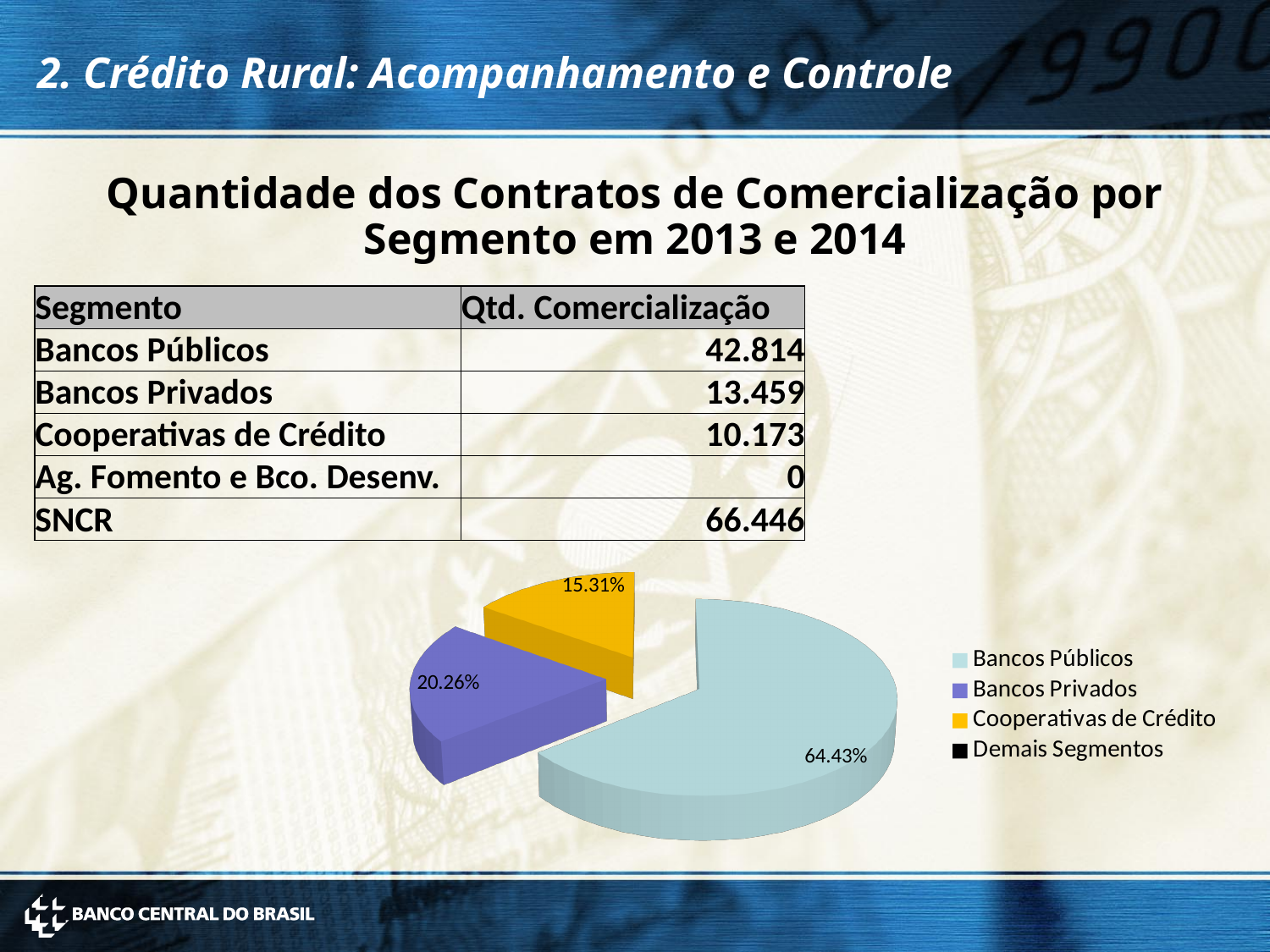
Which legend entry is shown in black? Demais Segmentos What is the difference in percentage points between the Bancos Públicos slice and the Bancos Privados slice? 44.17 How many entries does the legend of the pie chart list? 4 Which segment has the largest slice of the pie? Bancos Públicos How many slices have a percentage label on the pie chart? 3 What share of the pie does Bancos Privados hold? 20.26% Which slice is larger, Bancos Privados or Cooperativas de Crédito? Bancos Privados What share of the pie does Cooperativas de Crédito hold? 15.31% What share of the pie does Bancos Públicos hold? 64.43% Which of the labelled slices is the smallest? Cooperativas de Crédito What kind of chart is shown on the slide? Pie chart What colour is the Cooperativas de Crédito slice in the pie chart? Yellow